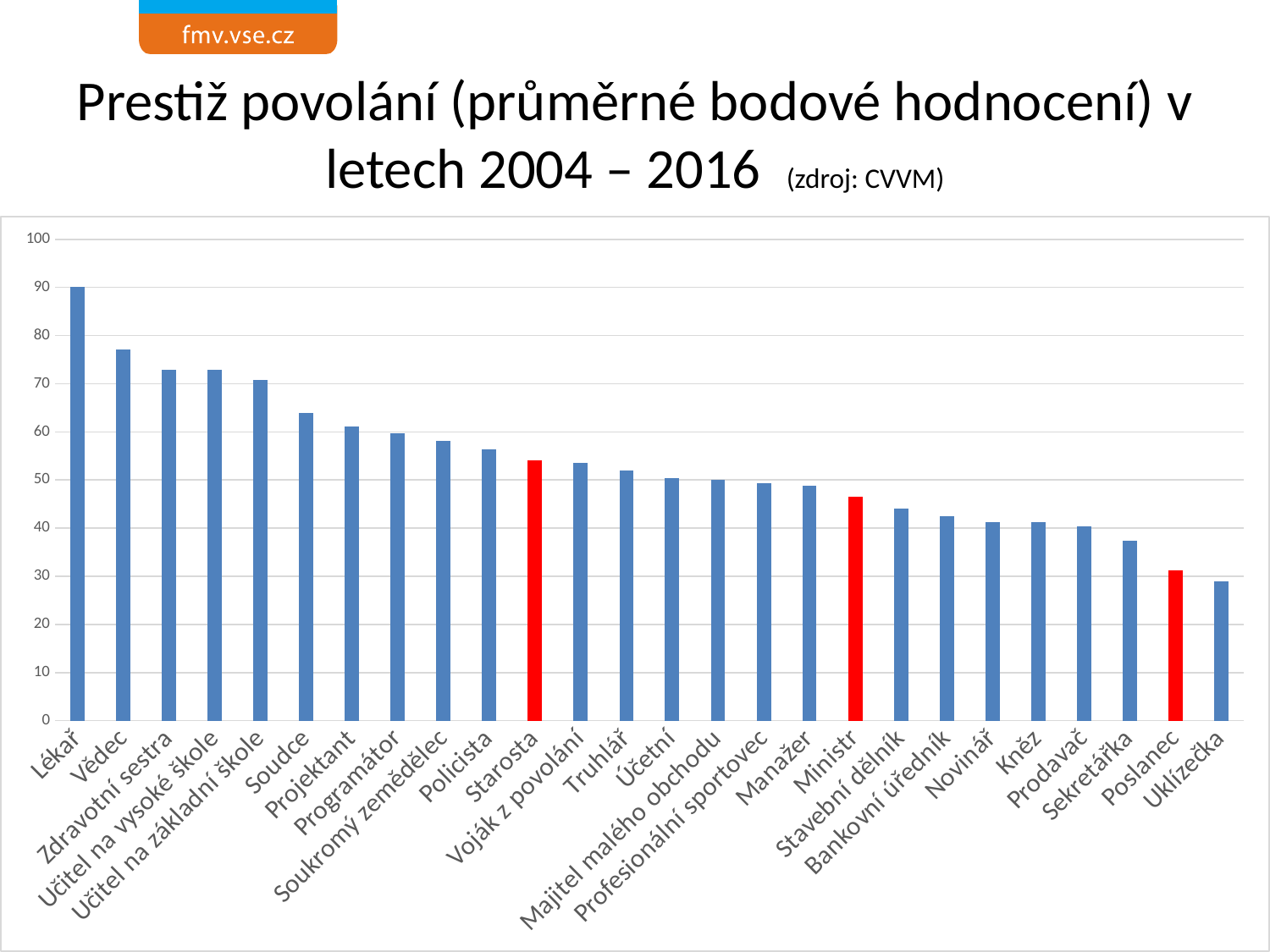
Is the value for Uklízečka greater or less than 30? less Is the value for Lékař greater or less than 80? greater Which profession has the highest bar in the chart? Lékař Which has the larger value, Vědec or Soudce? Vědec Do the values rise or fall moving from left to right along the x axis? fall Which has the larger value, Ministr or Poslanec? Ministr How many bars in the chart are coloured red? 3 Is the value for Starosta greater or less than 50? greater Which profession has the lowest bar in the chart? Uklízečka How many professions are shown on the x axis of the chart? 26 What kind of chart is shown on the slide? bar chart